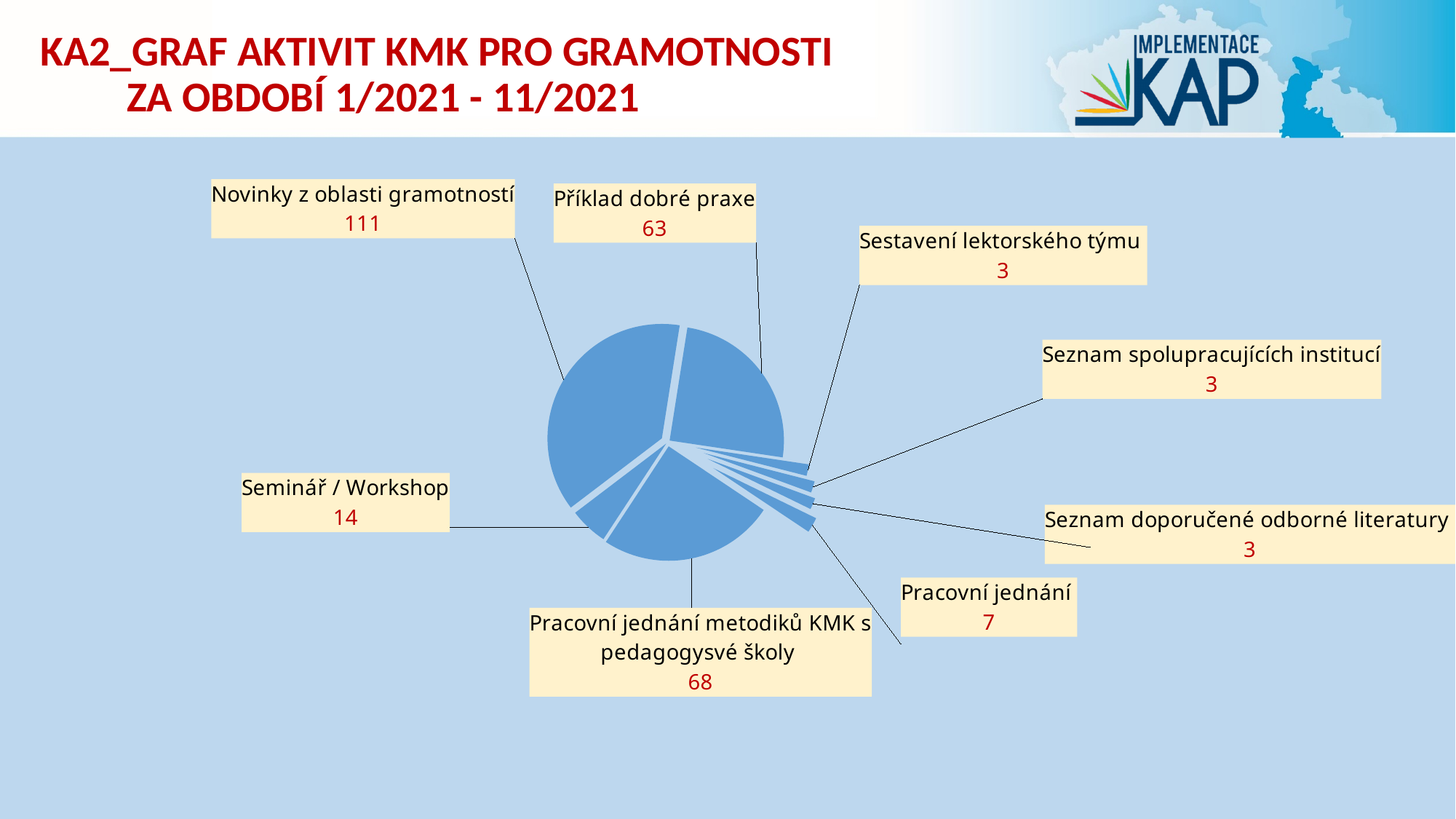
What type of chart is shown on the slide? Pie chart What value is shown for Novinky z oblasti gramotností? 111 What is the total of all values shown in the pie chart? 272 What share of the pie does Pracovní jednání metodiků KMK s pedagogysvé školy represent? 25% Which category has the highest value in the pie chart? Novinky z oblasti gramotností Which is larger: Příklad dobré praxe or Pracovní jednání metodiků KMK s pedagogysvé školy? Pracovní jednání metodiků KMK s pedagogysvé školy What is the difference between the values for Novinky z oblasti gramotností and Příklad dobré praxe? 48 What value is shown for Seminář / Workshop? 14 What value is shown for Příklad dobré praxe? 63 What is the smallest value shown on the pie chart? 3 What value is shown for Pracovní jednání? 7 How many slices does the pie chart have? 8